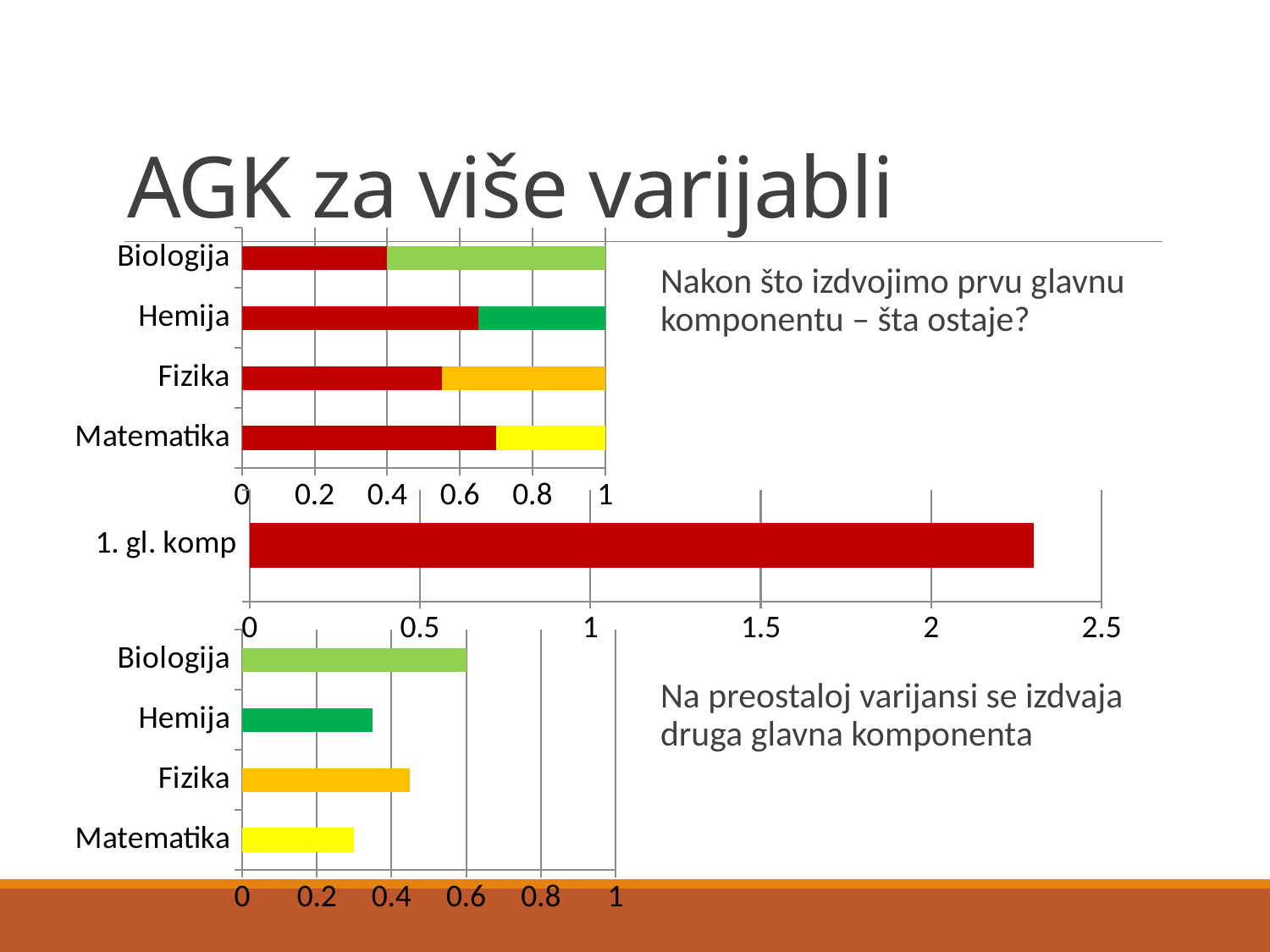
What is the category label of the single bar in the middle chart? 1. gl. komp In the bottom chart, is the value for Matematika greater or less than 0.4? less In the bottom chart, which category has the highest value? Biologija In the top stacked bar chart, which is larger, the red segment for Hemija or the red segment for Biologija? Hemija In the middle chart, is the value for 1. gl. komp greater or less than 2? greater What kind of chart is the bottom chart on the slide? bar chart In the bottom chart, is the value for Biologija greater or less than 0.5? greater How many categories does the bottom chart show? 4 How many categories does the top stacked bar chart show? 4 In the bottom chart, which is larger, the value for Fizika or the value for Hemija? Fizika